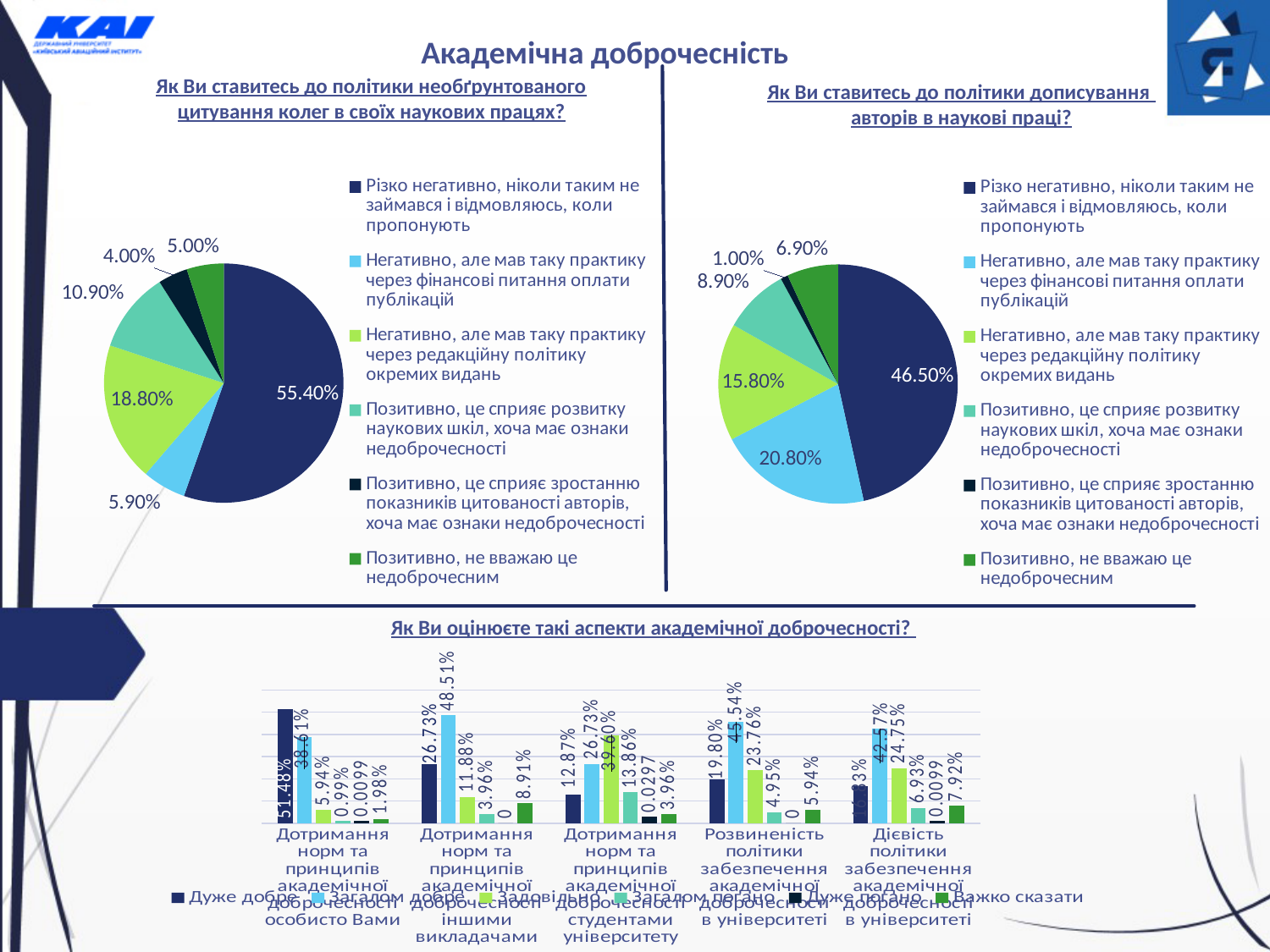
In the bottom bar chart, how many series does the legend list? 6 In the right pie chart about adding authors to scientific papers, what share chose "Негативно, але мав таку практику через фінансові питання оплати публікацій"? 20.80% In the right pie chart about adding authors to scientific papers, what share chose "Різко негативно, ніколи таким не займався і відмовляюсь, коли пропонують"? 46.50% In the right pie chart about adding authors to scientific papers, what is the difference between the largest slice (46.50%) and the 20.80% slice? 25.70% In the left pie chart about unjustified citation of colleagues, how many slices does the pie have? 6 In the left pie chart about unjustified citation of colleagues, what share of respondents chose "Різко негативно, ніколи таким не займався і відмовляюсь, коли пропонують"? 55.40% In the left pie chart about unjustified citation of colleagues, what share chose "Негативно, але мав таку практику через редакційну політику окремих видань"? 18.80% In the bottom bar chart, what is the value of "Дуже добре" for "Дотримання норм та принципів академічної доброчесності особисто Вами"? 51.48% In the bottom bar chart, what is the value of "Загалом добре" for "Дотримання норм та принципів академічної доброчесності іншими викладачами"? 48.51% In the right pie chart about adding authors to scientific papers, which is larger: the share for "Позитивно, не вважаю це недоброчесним" or for "Позитивно, це сприяє зростанню показників цитованості авторів"? Позитивно, не вважаю це недоброчесним In the left pie chart about unjustified citation of colleagues, which response has the smallest share? Позитивно, це сприяє зростанню показників цитованості авторів, хоча має ознаки недоброчесності What type of chart is used for "Як Ви оцінюєте такі аспекти академічної доброчесності?" at the bottom of the slide? bar chart